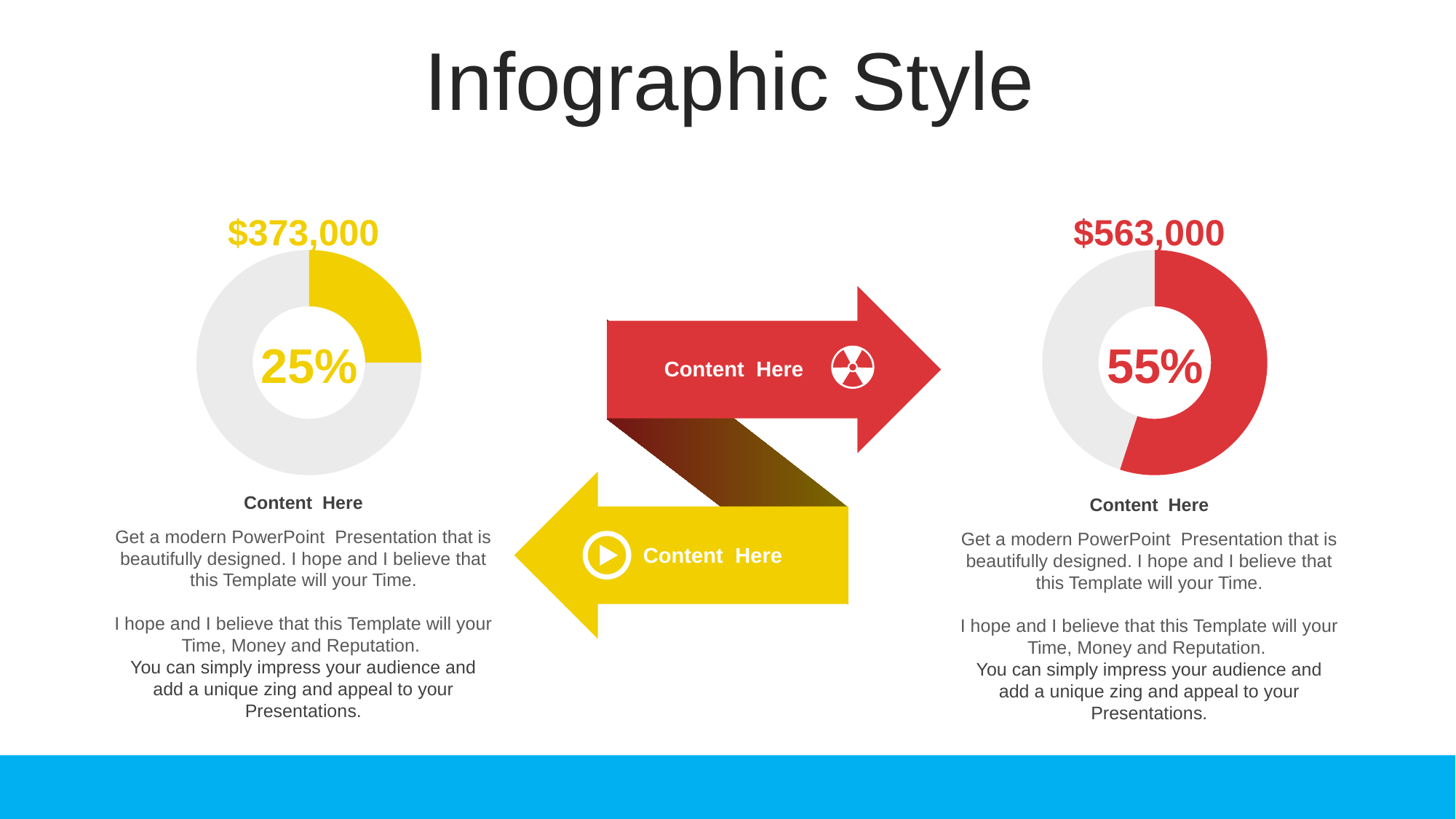
What colour is the filled segment of the left donut chart? yellow What percentage is shown in the centre of the right donut chart? 55% What is the difference between the percentages shown in the right and left donut charts? 30% Which donut chart shows the larger percentage, the left one or the right one? the right one Is the percentage shown in the left donut chart greater or less than 50%? less What dollar value is printed above the left donut chart? $373,000 What colour is the filled segment of the right donut chart? red How many donut charts are on the slide? 2 What kind of chart is used on the left side of the slide? donut chart What is the difference between the dollar values printed above the right and left donut charts? $190,000 What percentage is shown in the centre of the left donut chart? 25% What dollar value is printed above the right donut chart? $563,000